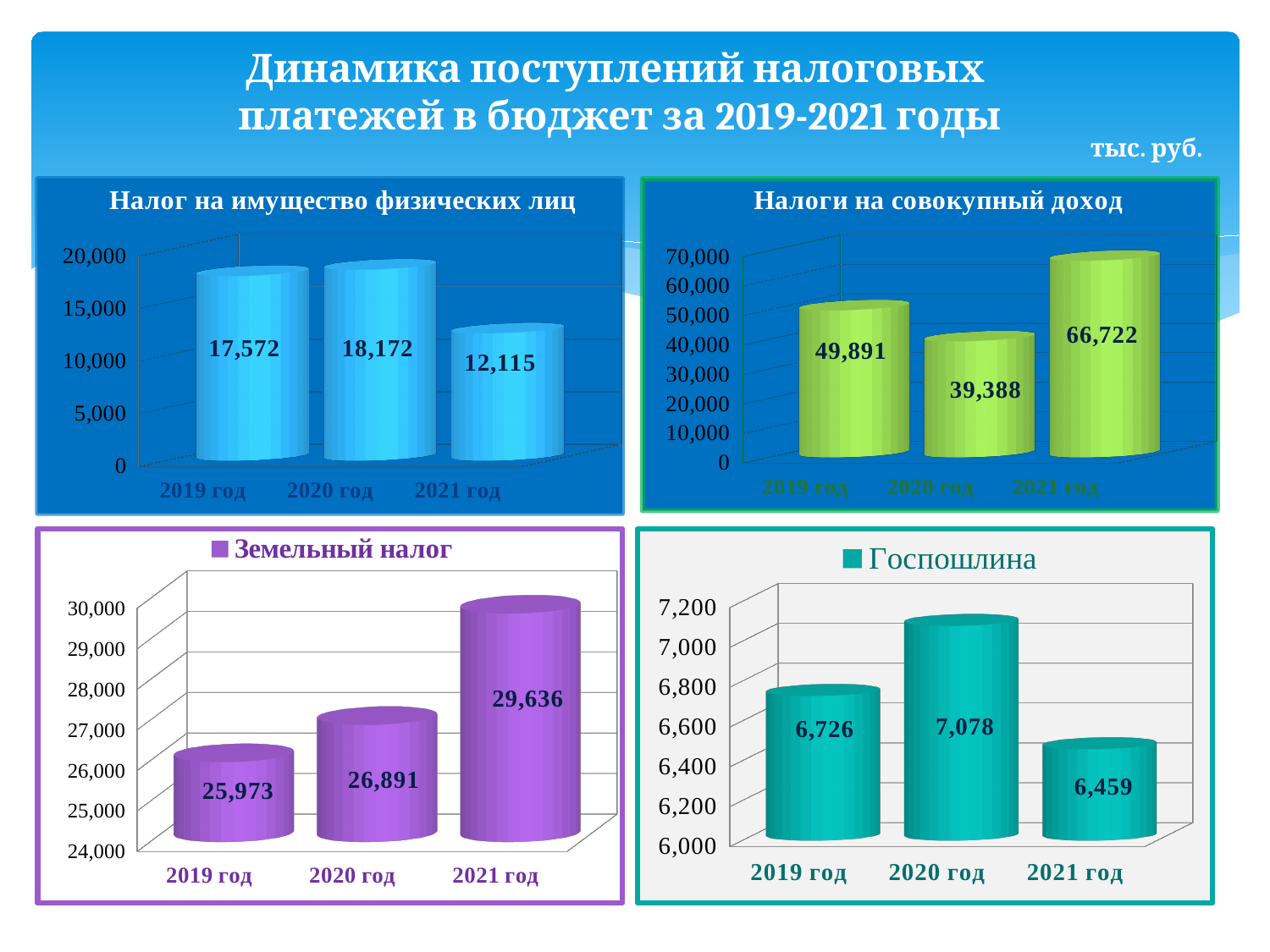
In the chart titled 'Налоги на совокупный доход', which year has the highest value? 2021 год How many categories (years) are shown in the chart titled 'Госпошлина'? 3 What type of chart is the one titled 'Земельный налог'? bar chart In the chart titled 'Земельный налог', do the values rise or fall from 2019 год to 2021 год? rise In the chart titled 'Госпошлина', which year has the lowest value? 2021 год In the chart titled 'Земельный налог', what is the difference between the values for 2021 год and 2019 год? 3,663 How many charts are shown on the slide? 4 In the chart titled 'Госпошлина', what is the value for 2019 год? 6,726 In the chart titled 'Налог на имущество физических лиц', what is the value for 2020 год? 18,172 In the chart titled 'Налоги на совокупный доход', what is the difference between the values for 2021 год and 2020 год? 27,334 In the chart titled 'Налог на имущество физических лиц', which is larger: the value for 2019 год or 2021 год? 2019 год In the chart titled 'Налоги на совокупный доход', what is the value for 2020 год? 39,388